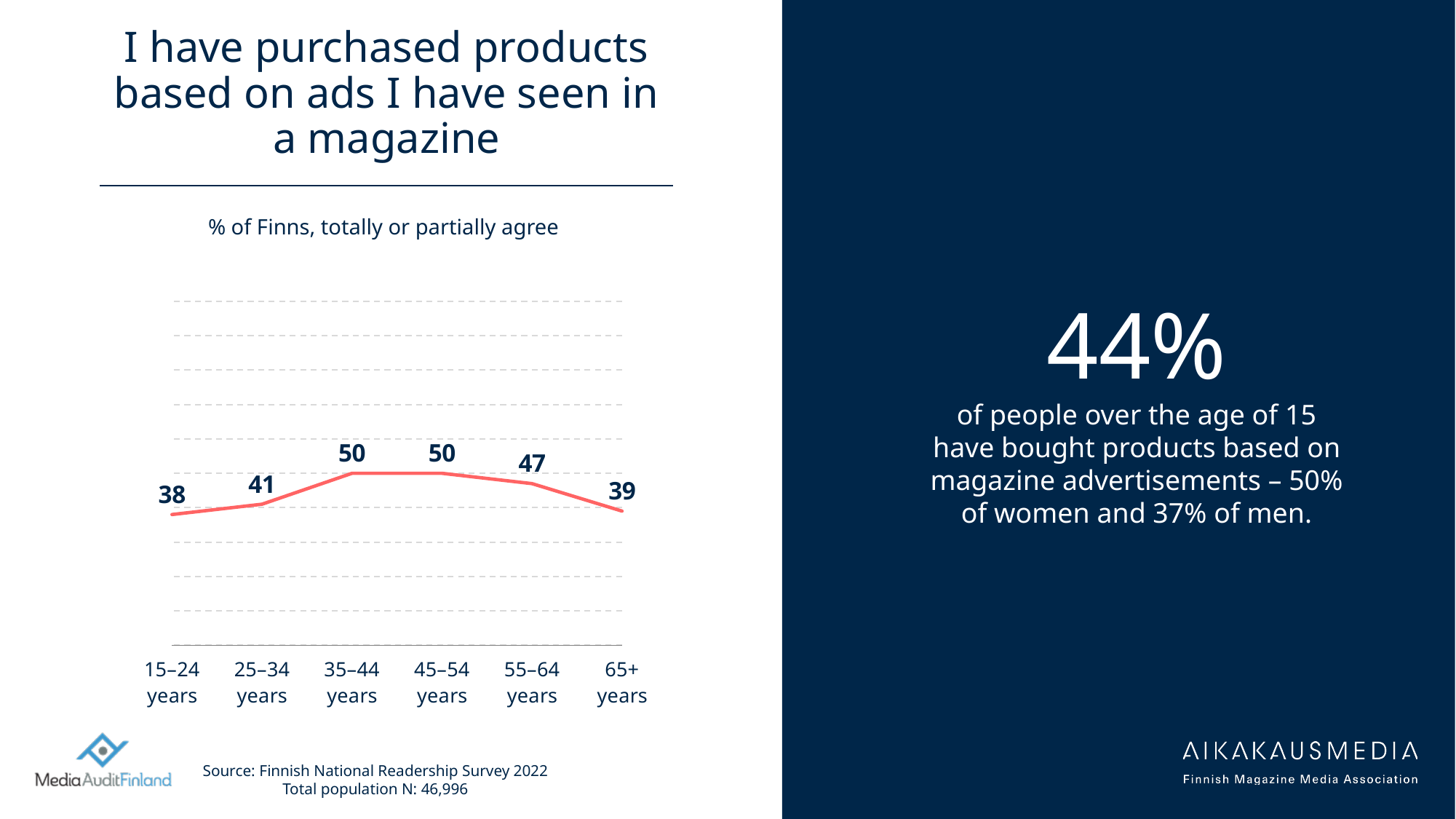
Which age group has the lowest value? 15–24 years What is the difference between the values for 55–64 years and 65+ years? 8 Which is larger, the value for 25–34 years or the value for 65+ years? 25–34 years What is the difference between the values for 35–44 years and 15–24 years? 12 How many age groups are plotted on the chart? 6 What is the value for the 65+ years age group? 39 What kind of chart is shown on the slide? line chart Do the values rise or fall from 45–54 years to 65+ years? fall What is the highest value shown on the line? 50 What is the subtitle shown above the chart? % of Finns, totally or partially agree What is the value for the 15–24 years age group? 38 What is the value for the 55–64 years age group? 47